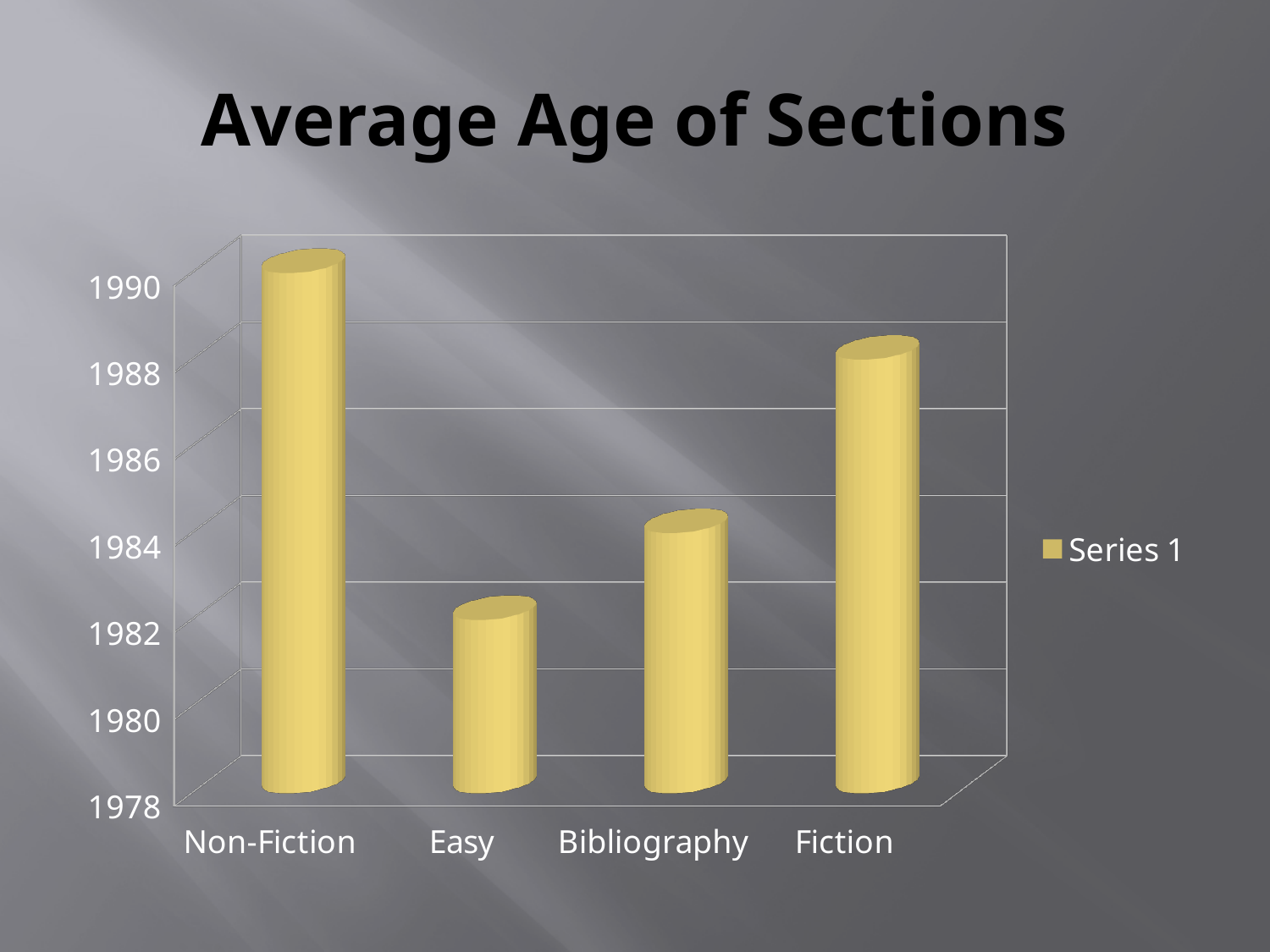
What kind of chart is shown on the slide? bar chart What is the name of the series shown in the legend? Series 1 What is the title of the chart? Average Age of Sections Is the value for Easy greater or less than 1984? less Which section has the highest value in the chart? Non-Fiction How many categories are shown on the x axis of the chart? 4 Is the value for Non-Fiction greater or less than 1988? greater Which has the larger value, Easy or Non-Fiction? Non-Fiction Which section has the lowest value in the chart? Easy Is the value for Fiction greater or less than 1986? greater Which has the larger value, Fiction or Bibliography? Fiction How many series does the legend list? 1